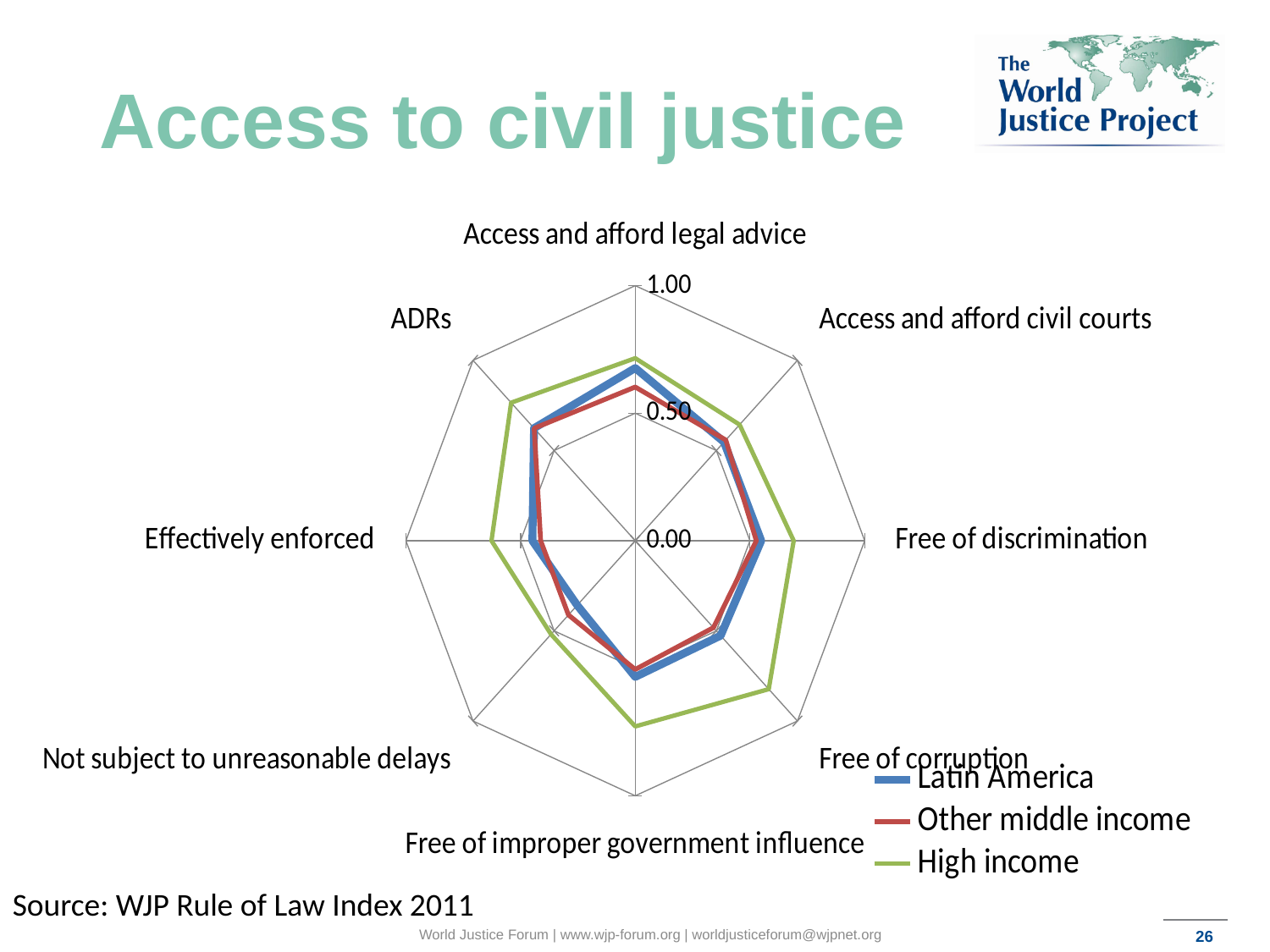
Is the value for High income on Free of corruption greater or less than 0.50? greater Which is larger on Free of discrimination: High income or Other middle income? High income Is the value for Other middle income on Access and afford legal advice greater or less than 0.50? greater How many categories (axes) does the radar chart have? 8 Is the value for High income on Free of discrimination greater or less than 0.50? greater What is the title of the slide containing the chart? Access to civil justice Which series is shown with a green line? High income What kind of chart is shown on the slide? Radar chart Which is larger on Free of corruption: High income or Latin America? High income Which series has the highest value on Free of corruption? High income How many series does the legend list? 3